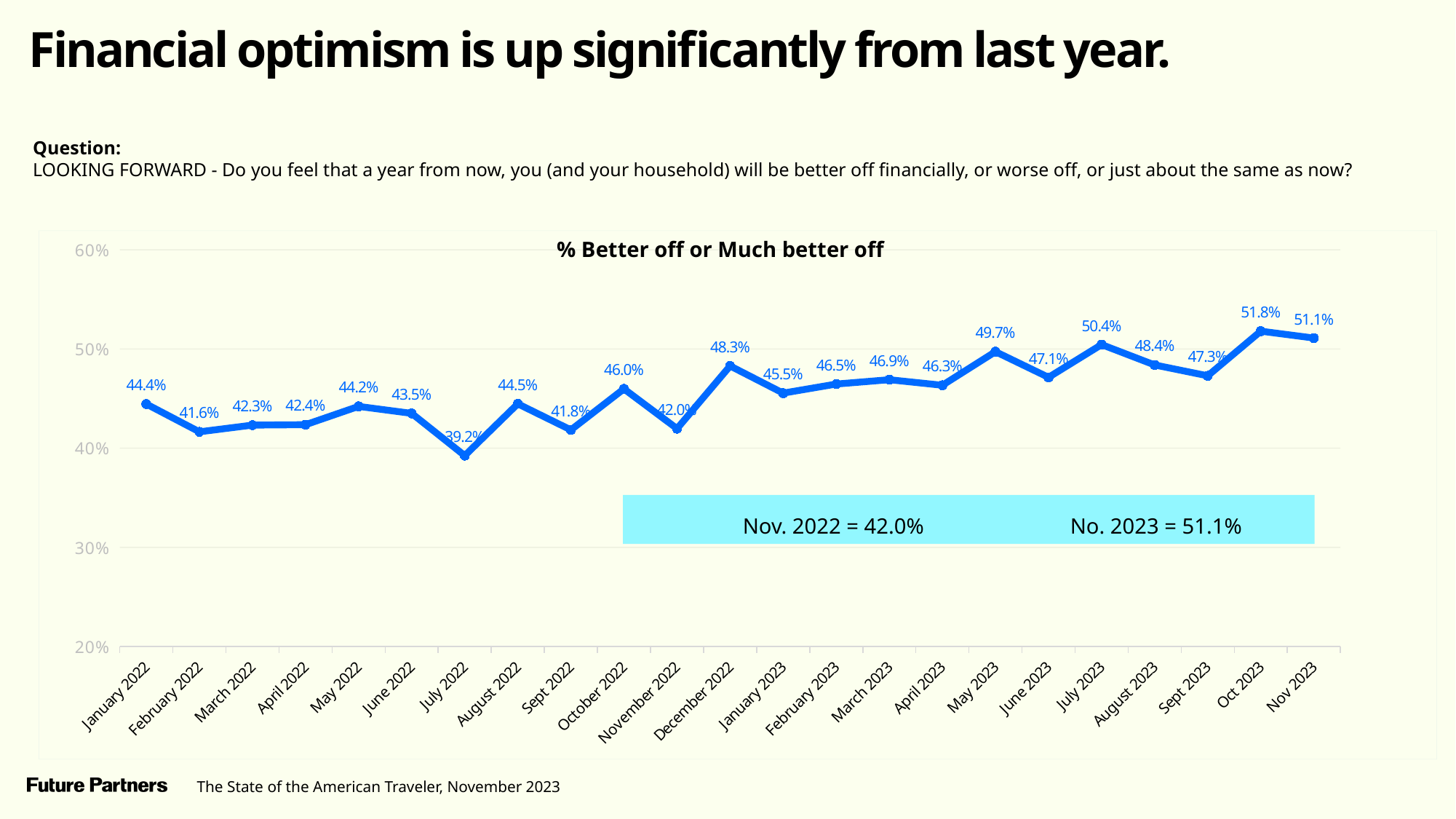
What is the value for May 2023? 49.7% What is the value for January 2022? 44.4% What is the difference between the values for Nov 2023 and November 2022? 9.1% What is the title of the chart? % Better off or Much better off Which month has the highest value? Oct 2023 What is the value for Nov 2023? 51.1% Which month has the lowest value? July 2022 Which is larger, the value for December 2022 or the value for January 2023? December 2022 What kind of chart is shown? line chart Is the value for July 2023 greater or less than 50%? greater What is the value for July 2022? 39.2% How many months are plotted on the chart? 23